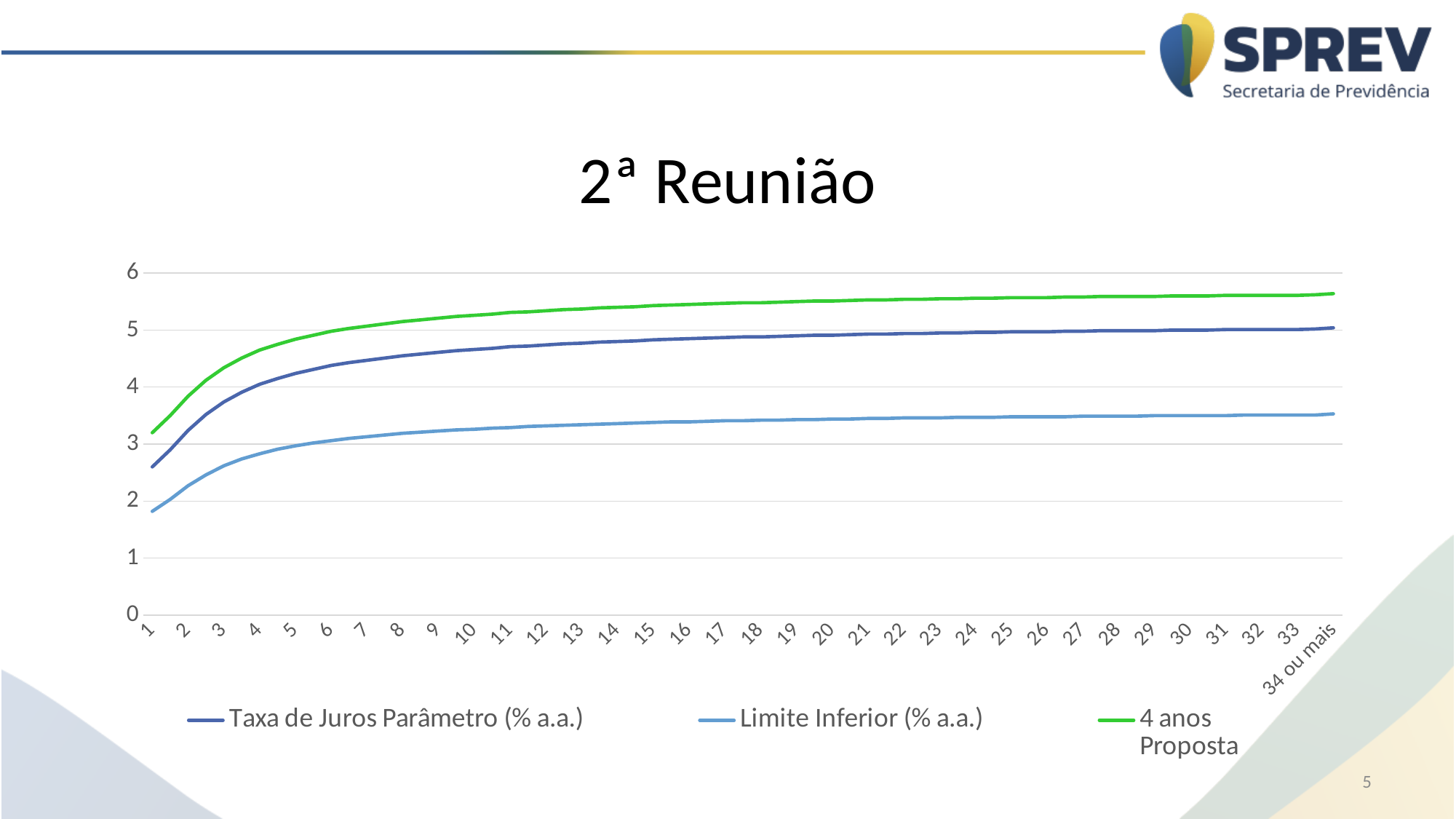
Do the values of the 'Limite Inferior (% a.a.)' series rise or fall along the x axis? rise How many series does the legend list? 3 What is the title of the slide containing the chart? 2ª Reunião Which series has the lowest values across the chart? Limite Inferior (% a.a.) Which series has the highest values across the chart? 4 anos Proposta Is the value for '4 anos Proposta' at category 1 greater or less than 3? greater Is the value for 'Limite Inferior (% a.a.)' at category 1 greater or less than 2? less What is the label of the last category on the x axis? 34 ou mais What kind of chart is shown on the slide? line chart Is the value for '4 anos Proposta' at '34 ou mais' greater or less than 6? less At category 1, which is larger: 'Taxa de Juros Parâmetro (% a.a.)' or 'Limite Inferior (% a.a.)'? Taxa de Juros Parâmetro (% a.a.)